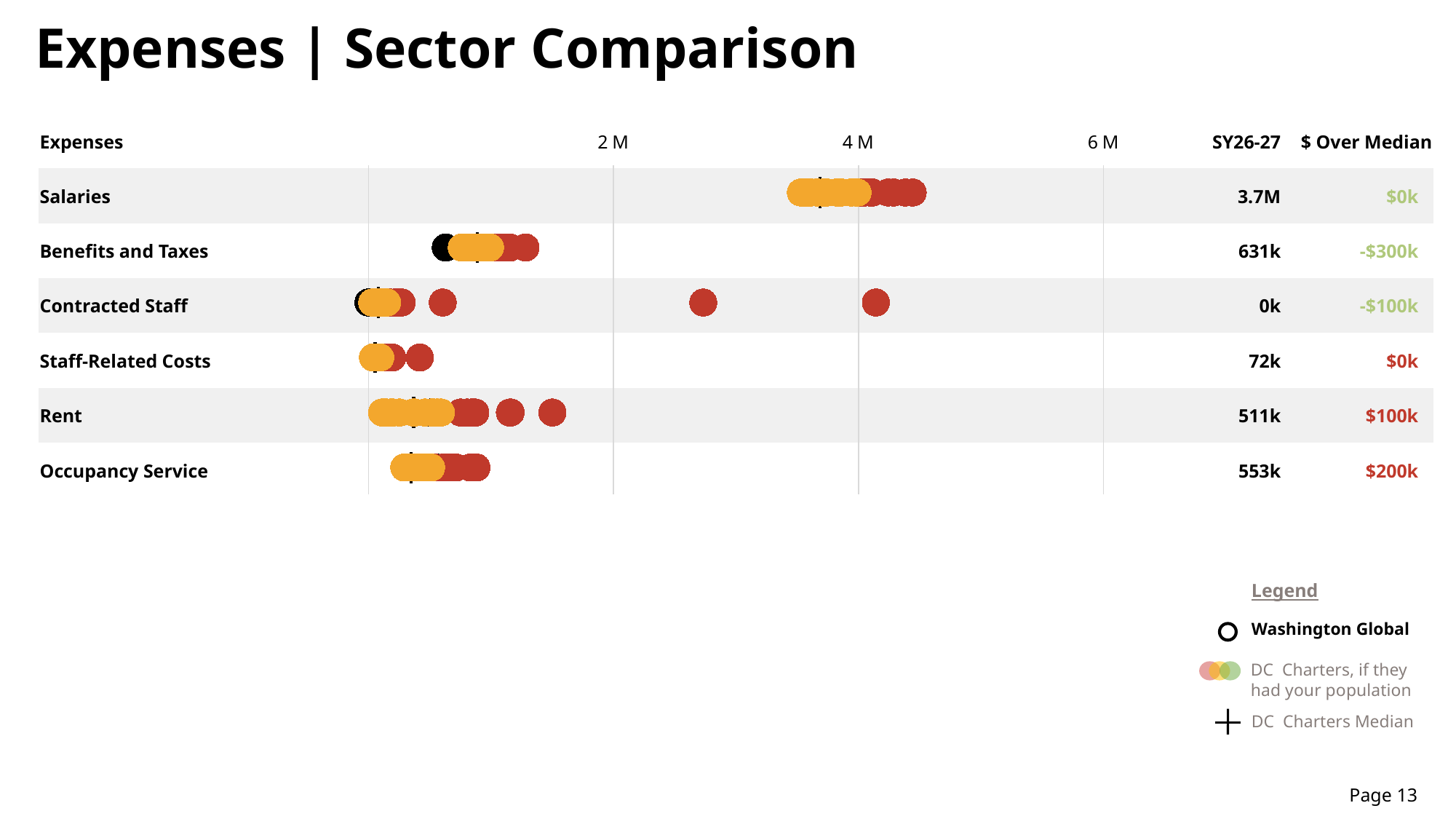
What is the $ Over Median value for Occupancy Service? $200k What is the SY26-27 value for Rent? 511k Which expense category has the highest SY26-27 value? Salaries Which expense category has the highest $ Over Median value? Occupancy Service How many expense categories are shown in the chart? 6 How many entries does the legend list? 3 Which has a larger SY26-27 value, Benefits and Taxes or Occupancy Service? Benefits and Taxes What is the $ Over Median value for Benefits and Taxes? -$300k What is the difference between the SY26-27 values for Occupancy Service and Rent? 42k Which expense category has the lowest SY26-27 value? Contracted Staff What is the SY26-27 value for Salaries? 3.7M Is the SY26-27 value for Salaries greater or less than 2 M? greater